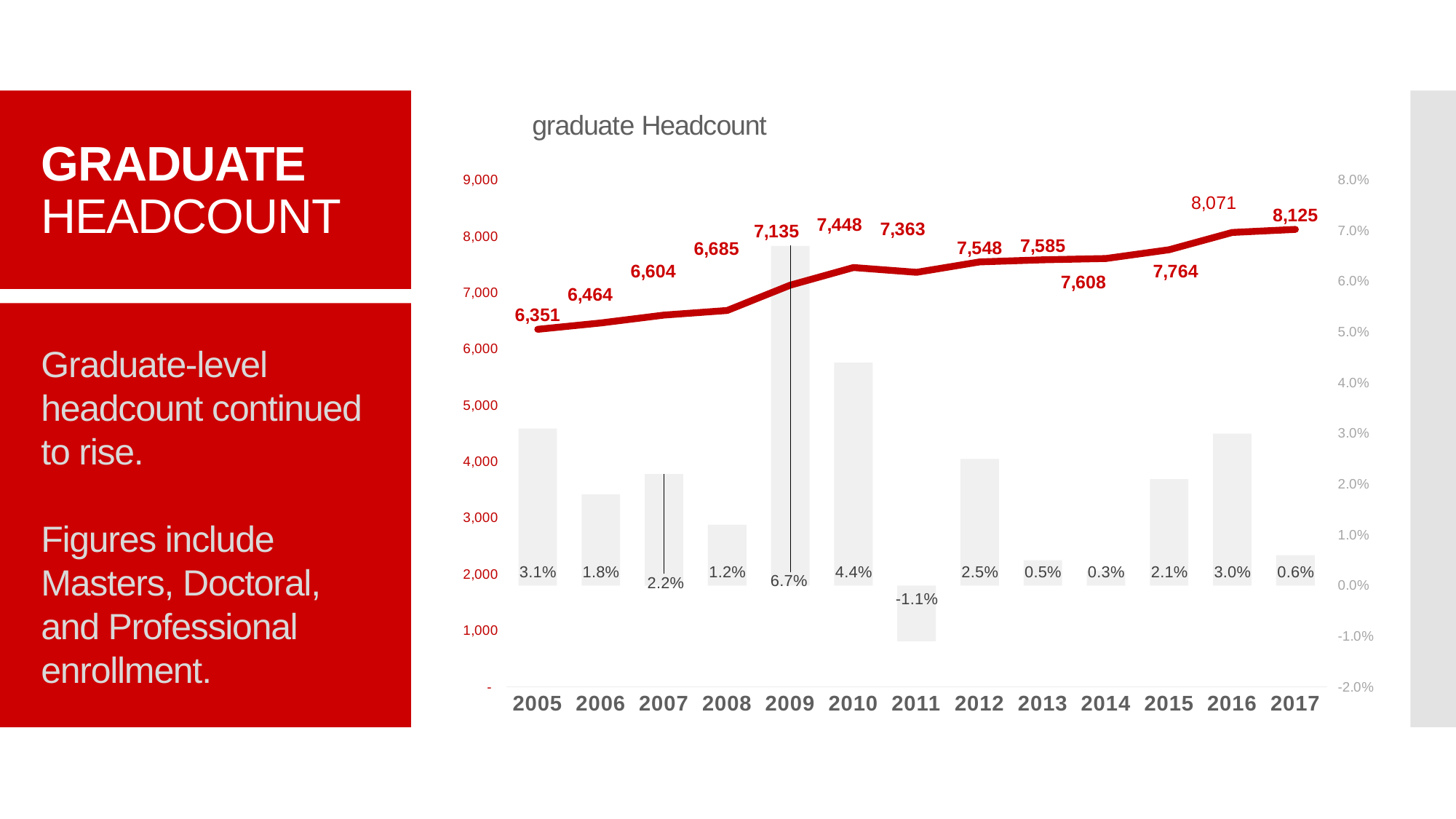
What is the difference in graduate headcount between 2017 and 2005? 1,774 Which year has the highest graduate headcount? 2017 What is the graduate headcount for 2005? 6,351 What percentage change is shown for 2011? -1.1% What percentage change is shown for 2009? 6.7% How many years are shown on the x axis? 13 What is the graduate headcount for 2016? 8,071 Which year has a larger graduate headcount, 2010 or 2011? 2010 Which year has the lowest percentage change bar? 2011 What is the title of the chart? graduate Headcount Does the graduate headcount line generally rise or fall from 2005 to 2017? rise What is the graduate headcount for 2017? 8,125